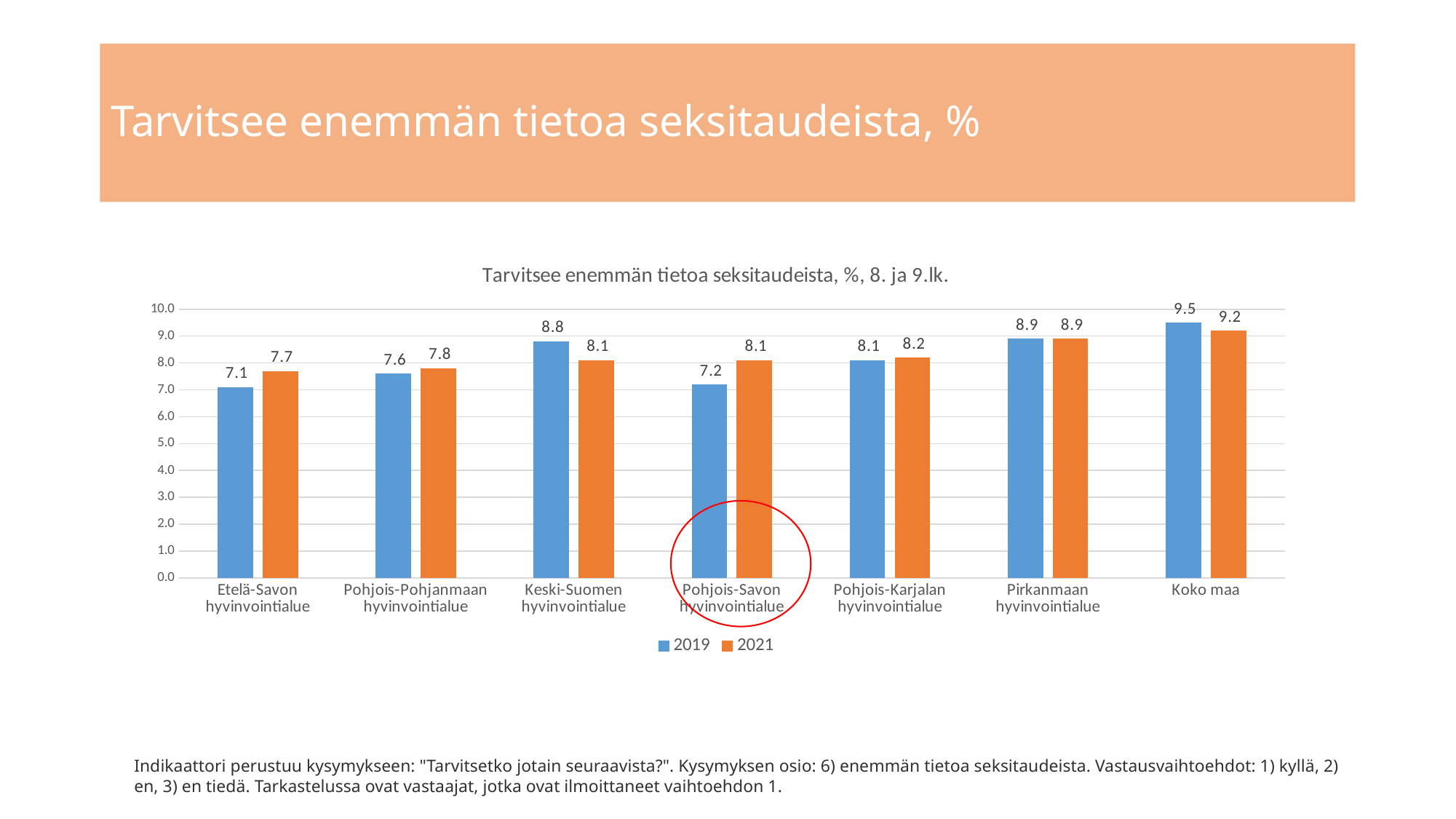
Which is larger for Keski-Suomen hyvinvointialue, the 2019 value or the 2021 value? 2019 Which category is circled in red on the chart? Pohjois-Savon hyvinvointialue What is the 2021 value for Etelä-Savon hyvinvointialue? 7.7 What kind of chart is shown on the slide? Bar chart How many categories are shown on the x axis? 7 What is the difference between the 2021 and 2019 values for Pohjois-Savon hyvinvointialue? 0.9 What is the title of the chart? Tarvitsee enemmän tietoa seksitaudeista, %, 8. ja 9.lk. How many series does the legend list? 2 Which category has the lowest 2019 value? Etelä-Savon hyvinvointialue What is the 2021 value for Koko maa? 9.2 Which category has the highest 2019 value? Koko maa What is the 2019 value for Pohjois-Savon hyvinvointialue? 7.2